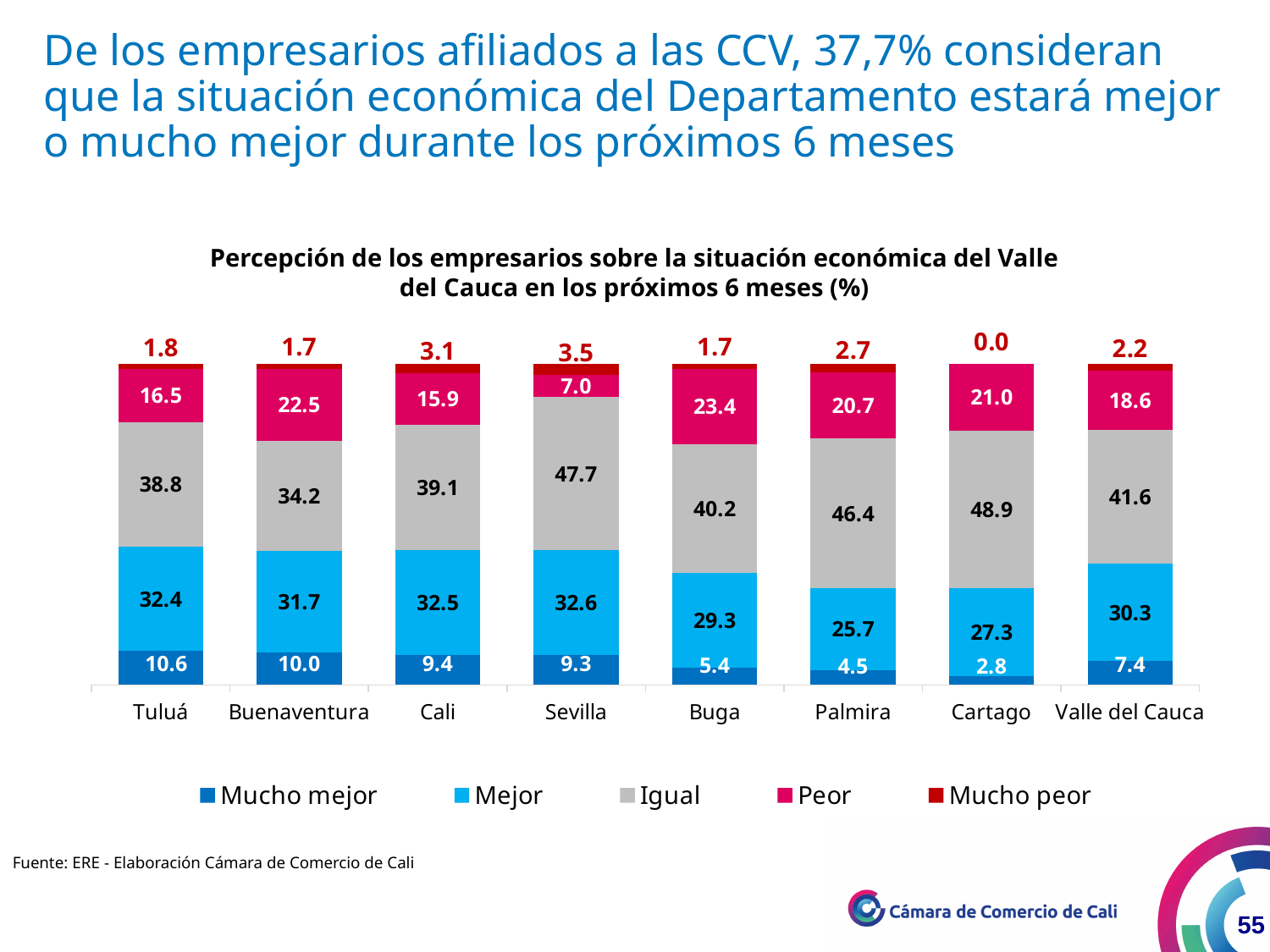
How many categories are shown on the x axis? 8 Which is larger, the 'Mejor' value for Buga or for Palmira? Buga What is the difference between the 'Mucho mejor' values for Tuluá and Cartago? 7.8 What type of chart is shown on the slide? Stacked bar chart Which category has the lowest 'Mucho mejor' value? Cartago Which category has the highest 'Mucho peor' value? Sevilla What is the 'Peor' value for Valle del Cauca? 18.6 What is the 'Mucho mejor' value for Tuluá? 10.6 What is the 'Mucho peor' value for Cartago? 0.0 What is the 'Igual' value for Sevilla? 47.7 How many series does the legend list? 5 Which category has the highest 'Igual' value? Cartago